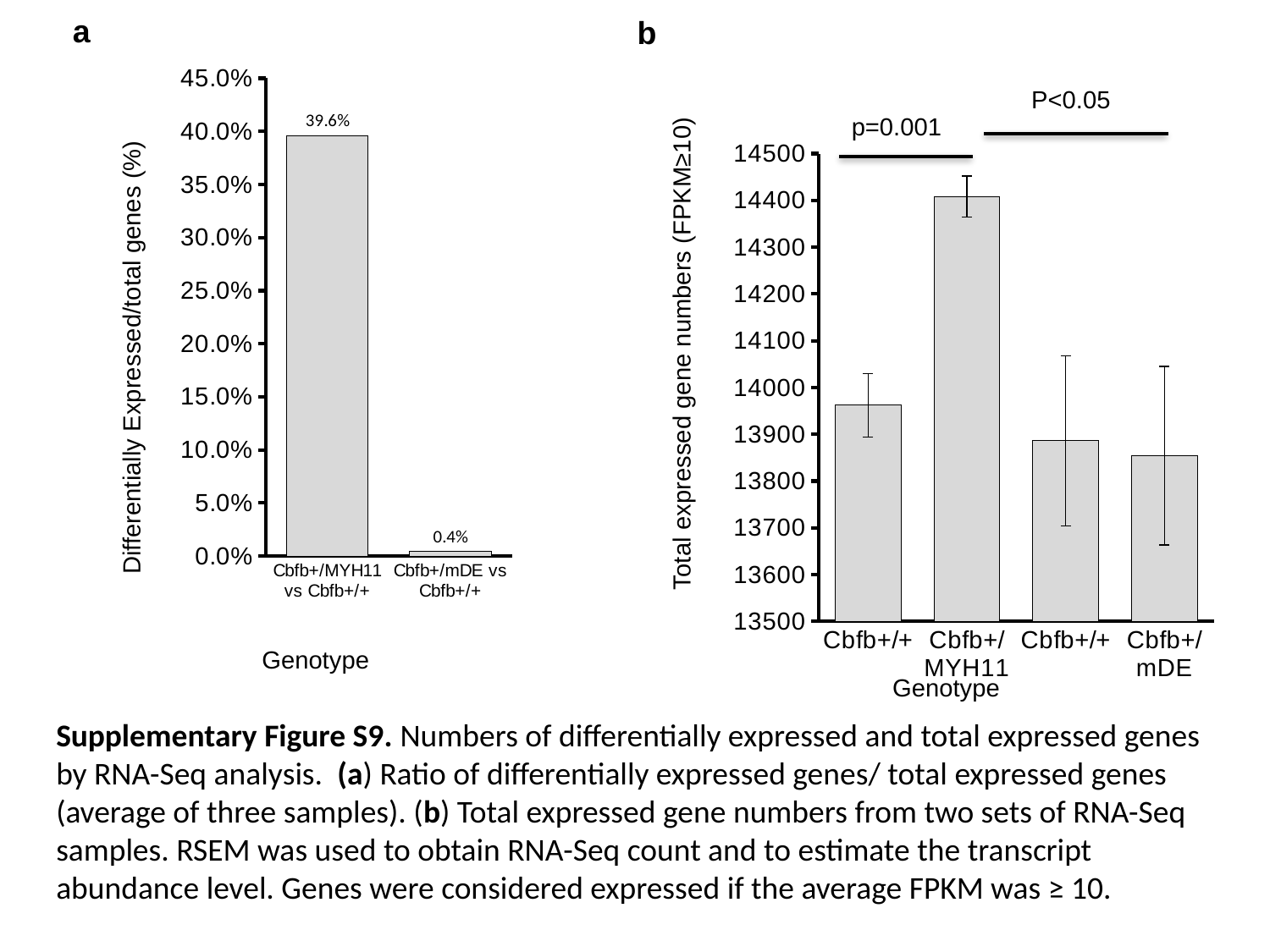
In chart b (right), is the value for Cbfb+/mDE greater or less than 14000? less What kind of chart is chart b (right)? Bar chart In chart b (right), is the value for Cbfb+/MYH11 greater or less than 14300? greater In chart a (left), what is the difference between the values for Cbfb+/MYH11 vs Cbfb+/+ and Cbfb+/mDE vs Cbfb+/+? 39.2% In chart a (left), how many bars are plotted? 2 In chart b (right), how many bars are plotted? 4 In chart a (left), what is the y-axis label? Differentially Expressed/total genes (%) In chart b (right), which genotype has the highest total expressed gene number? Cbfb+/MYH11 In chart a (left), which category has the highest value? Cbfb+/MYH11 vs Cbfb+/+ In chart a (left), what is the value for Cbfb+/mDE vs Cbfb+/+? 0.4% In chart b (right), which is larger: the value for Cbfb+/MYH11 or the value for Cbfb+/mDE? Cbfb+/MYH11 In chart a (left), what is the value for Cbfb+/MYH11 vs Cbfb+/+? 39.6%